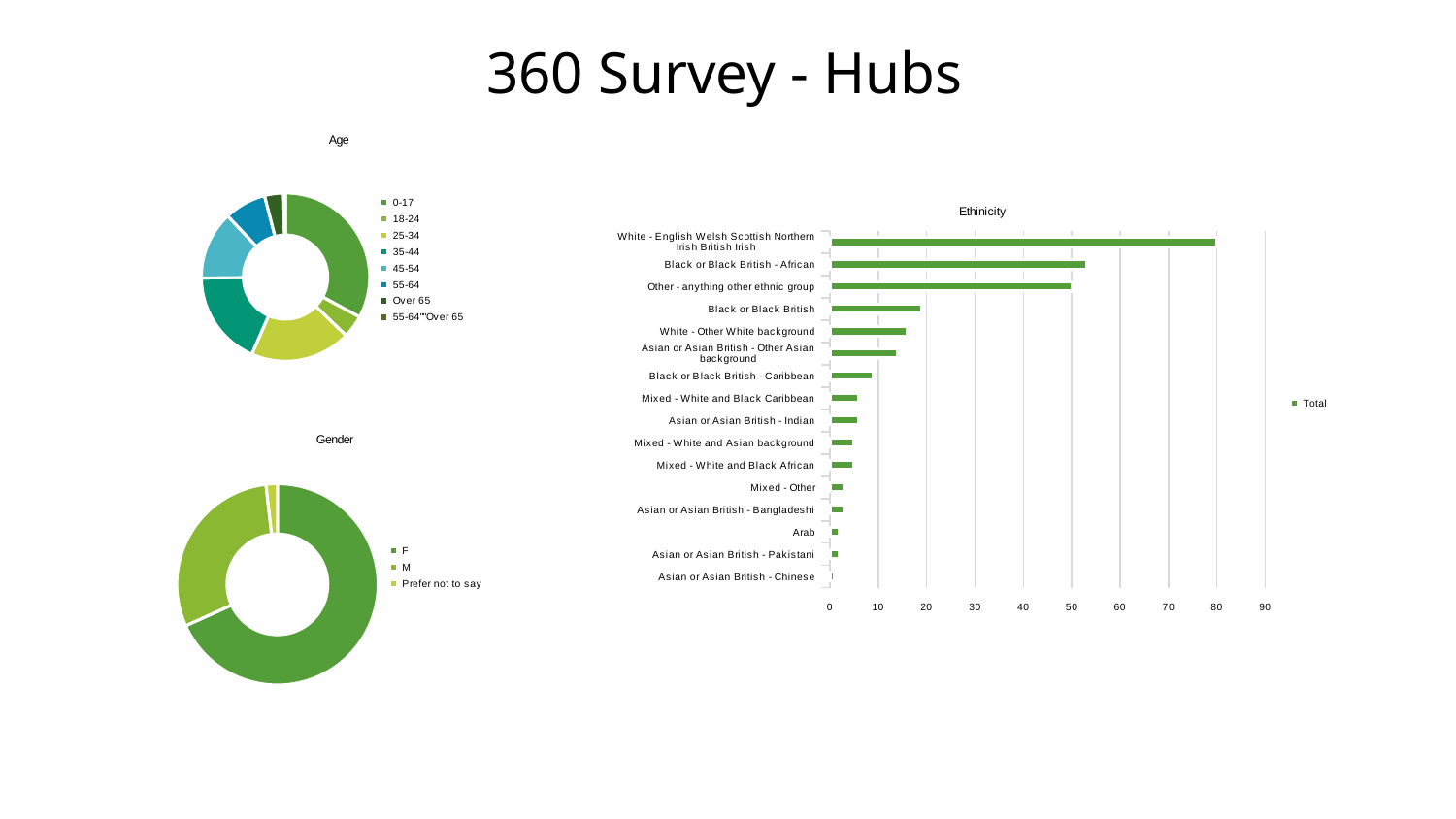
In the Gender chart, which category has the largest share? F In the Ethinicity chart, is the value for White - Other White background greater or less than 20? less How many categories are shown in the Ethinicity chart? 16 How many entries does the legend of the Gender chart list? 3 In the Ethinicity chart, which is larger: Black or Black British - Caribbean or Mixed - White and Black Caribbean? Black or Black British - Caribbean How many series does the legend of the Ethinicity chart list? 1 In the Ethinicity chart, is the value for White - English Welsh Scottish Northern Irish British Irish greater or less than 70? greater In the Ethinicity chart, which category has the lowest value? Asian or Asian British - Chinese What type of chart is the Age chart? doughnut chart What type of chart is the Ethinicity chart? bar chart In the Ethinicity chart, is the value for Black or Black British - African greater or less than 40? greater In the Ethinicity chart, which category has the highest value? White - English Welsh Scottish Northern Irish British Irish